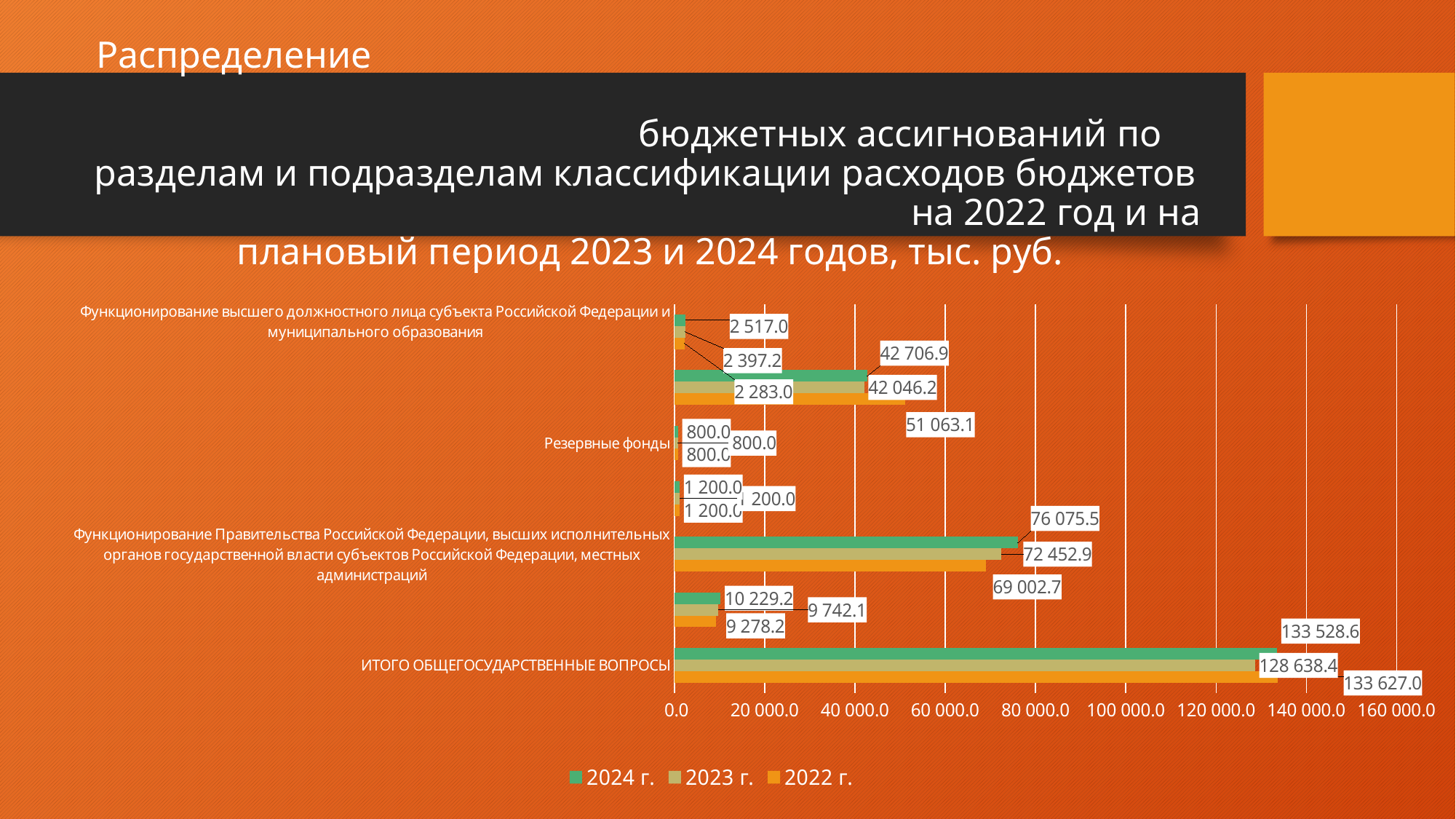
How many series does the legend list? 3 What is the value for 2023 г. for Функционирование Правительства Российской Федерации, высших исполнительных органов государственной власти субъектов Российской Федерации, местных администраций? 72 452.9 Which labeled category has the highest 2024 г. value? ИТОГО ОБЩЕГОСУДАРСТВЕННЫЕ ВОПРОСЫ What is the value for 2022 г. for ИТОГО ОБЩЕГОСУДАРСТВЕННЫЕ ВОПРОСЫ? 133 627.0 What is the value for 2024 г. for ИТОГО ОБЩЕГОСУДАРСТВЕННЫЕ ВОПРОСЫ? 133 528.6 What kind of chart is shown on the slide? bar chart What is the value for 2024 г. for Функционирование высшего должностного лица субъекта Российской Федерации и муниципального образования? 2 517.0 What is the value for 2022 г. for Резервные фонды? 800.0 Is the 2023 г. value for ИТОГО ОБЩЕГОСУДАРСТВЕННЫЕ ВОПРОСЫ greater or less than 120 000.0? greater Which is larger for ИТОГО ОБЩЕГОСУДАРСТВЕННЫЕ ВОПРОСЫ: the 2023 г. value or the 2024 г. value? 2024 г. Which series is shown in green in the legend? 2024 г. What is the difference between the 2024 г. and 2022 г. values for Функционирование Правительства Российской Федерации, высших исполнительных органов государственной власти субъектов Российской Федерации, местных администраций? 7 072.8